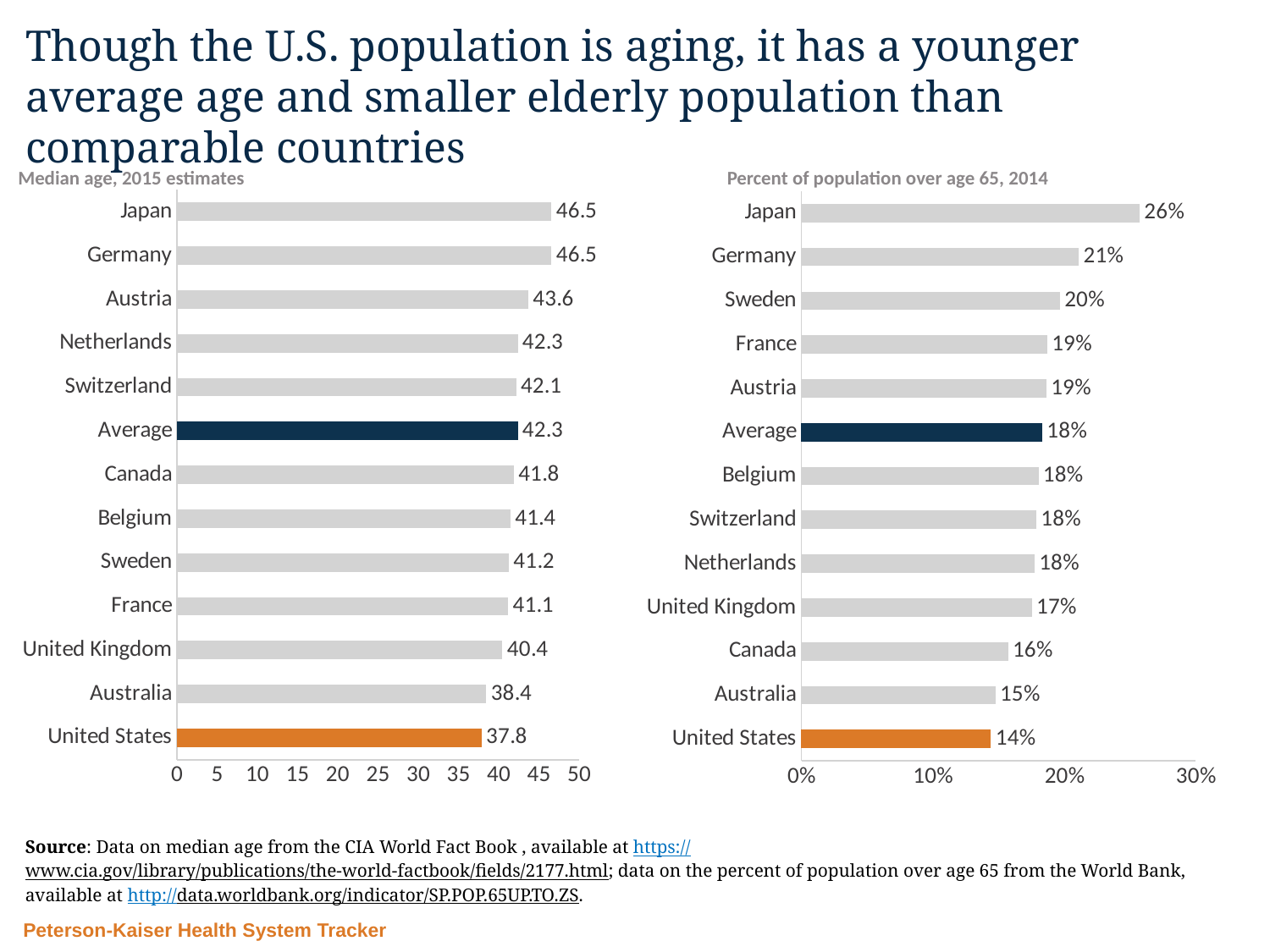
In the 'Percent of population over age 65, 2014' chart, which country has the highest percentage? Japan In the 'Percent of population over age 65, 2014' chart, what is the value for Sweden? 20% In the 'Percent of population over age 65, 2014' chart, what is the difference between Germany and the United States? 7% In the 'Percent of population over age 65, 2014' chart, which country has the lowest percentage? United States In the 'Median age, 2015 estimates' chart, what is the median age for Austria? 43.6 In the 'Median age, 2015 estimates' chart, how many bars are shown? 13 What type of chart is the 'Percent of population over age 65, 2014' chart? Bar chart In the 'Median age, 2015 estimates' chart, which bar is coloured orange? United States In the 'Median age, 2015 estimates' chart, which has a higher median age, Canada or Australia? Canada In the 'Median age, 2015 estimates' chart, which country has the lowest median age? United States In the 'Median age, 2015 estimates' chart, what is the difference between the median age of Japan and the United States? 8.7 In the 'Median age, 2015 estimates' chart, what is the median age for the United States? 37.8